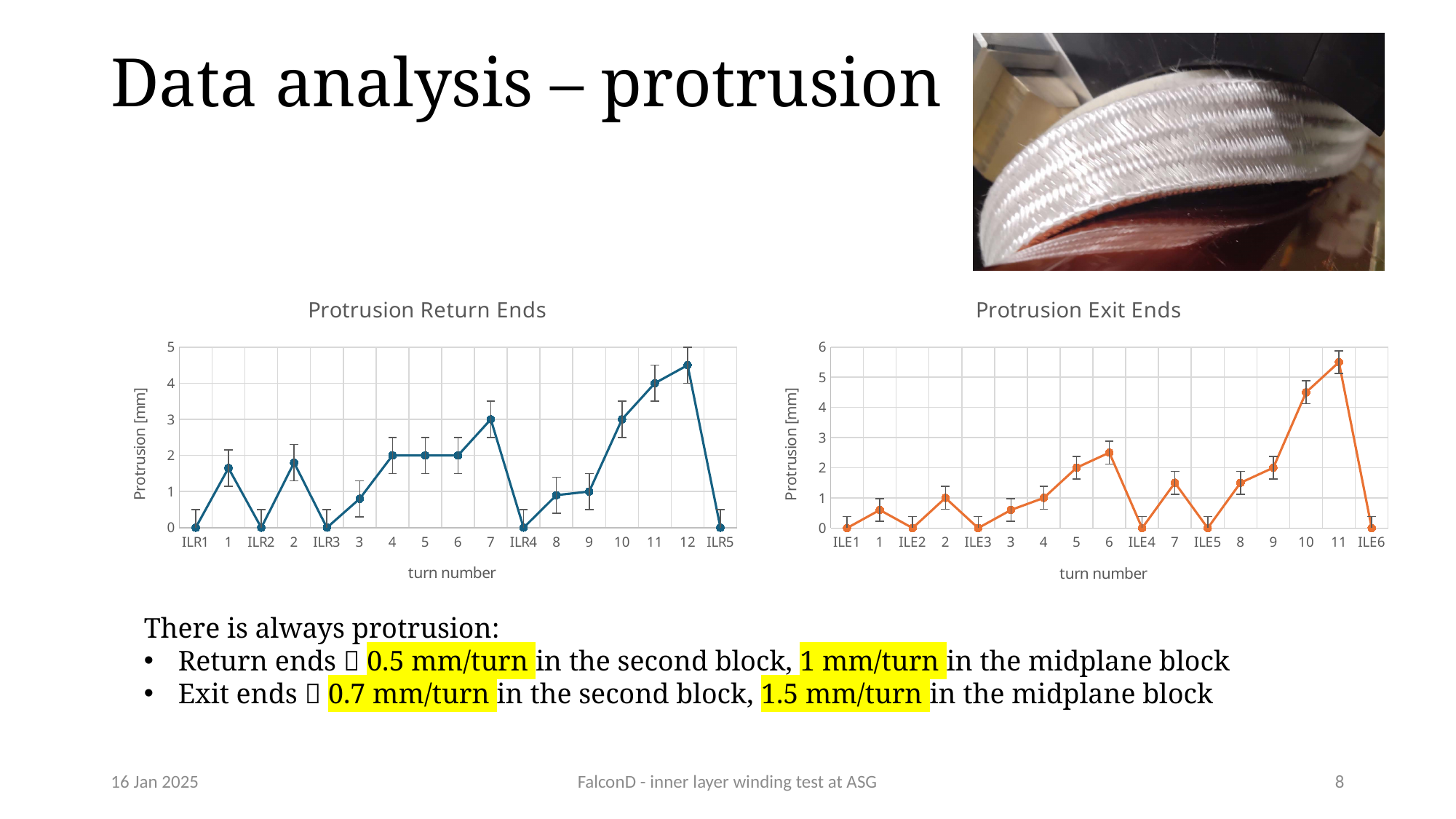
In the 'Protrusion Return Ends' chart, what is the protrusion at turn 7? 3 In the 'Protrusion Exit Ends' chart, which is larger, the value at turn 6 or the value at turn 7? turn 6 How many data points are plotted in the 'Protrusion Return Ends' chart? 17 In the 'Protrusion Exit Ends' chart, which turn number has the highest protrusion? 11 What type of chart is the 'Protrusion Return Ends' chart? line chart In the 'Protrusion Exit Ends' chart, what is the protrusion at turn 5? 2 In the 'Protrusion Return Ends' chart, what is the protrusion at turn 11? 4 In the 'Protrusion Return Ends' chart, which turn number has the highest protrusion? 12 What is the y-axis title of the 'Protrusion Exit Ends' chart? Protrusion [mm] In the 'Protrusion Return Ends' chart, is the value for turn 12 greater or less than 4? greater In the 'Protrusion Exit Ends' chart, what is the protrusion at ILE4? 0 In the 'Protrusion Exit Ends' chart, is the value for turn 10 greater or less than 4? greater